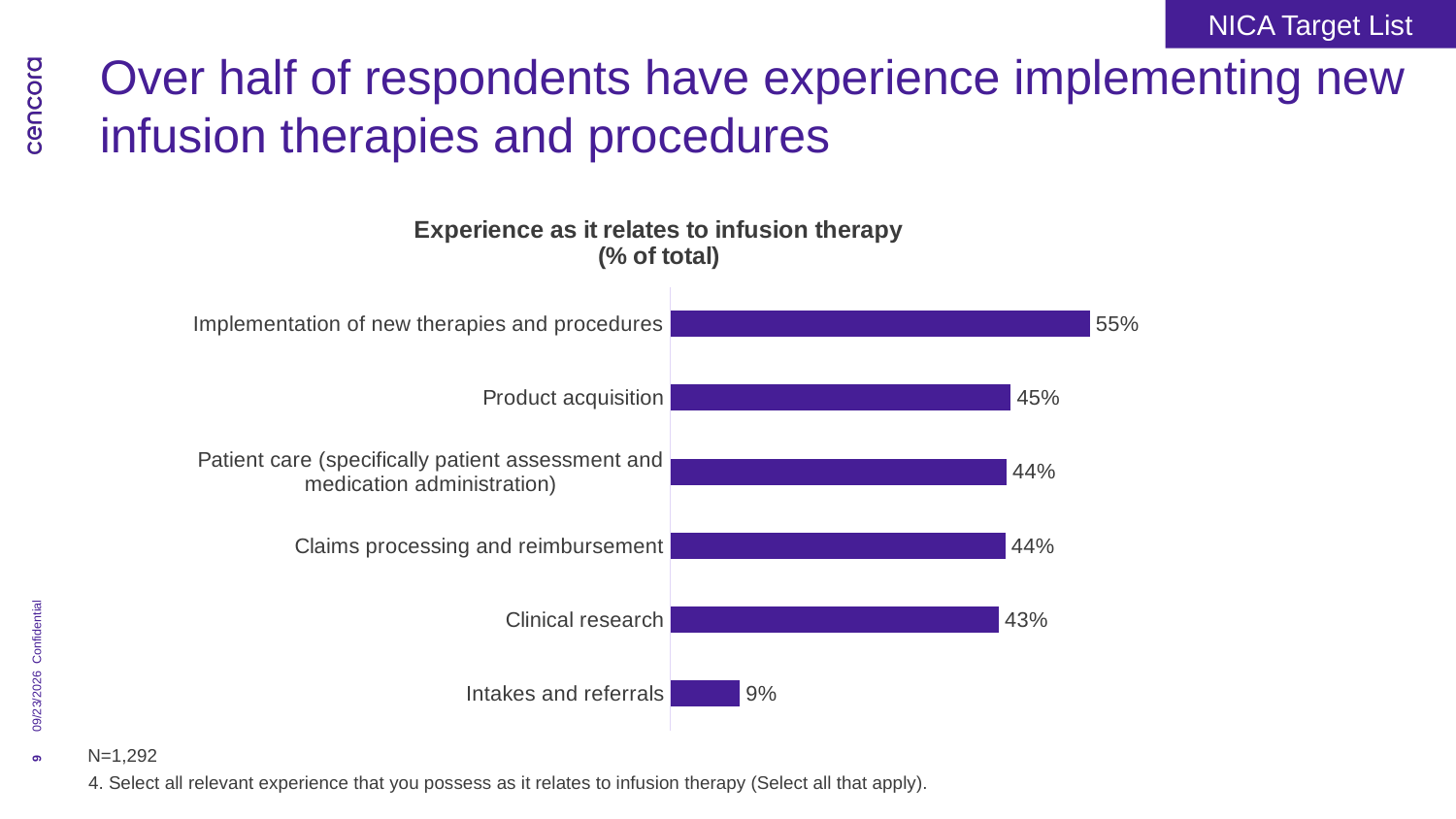
What kind of chart is shown on the slide? Bar chart Which is larger, the value for Product acquisition or the value for Intakes and referrals? Product acquisition Which category has the lowest value? Intakes and referrals What is the difference between the values for Implementation of new therapies and procedures and Intakes and referrals? 46% What is the value shown for Product acquisition? 45% How many categories are shown in the chart? 6 What is the value for Intakes and referrals? 9% What percentage of respondents have experience with implementation of new therapies and procedures? 55% What percentage is shown for Clinical research? 43% What is the title of the chart? Experience as it relates to infusion therapy (% of total) Which category has the highest value? Implementation of new therapies and procedures What is the difference between the values for Product acquisition and Clinical research? 2%